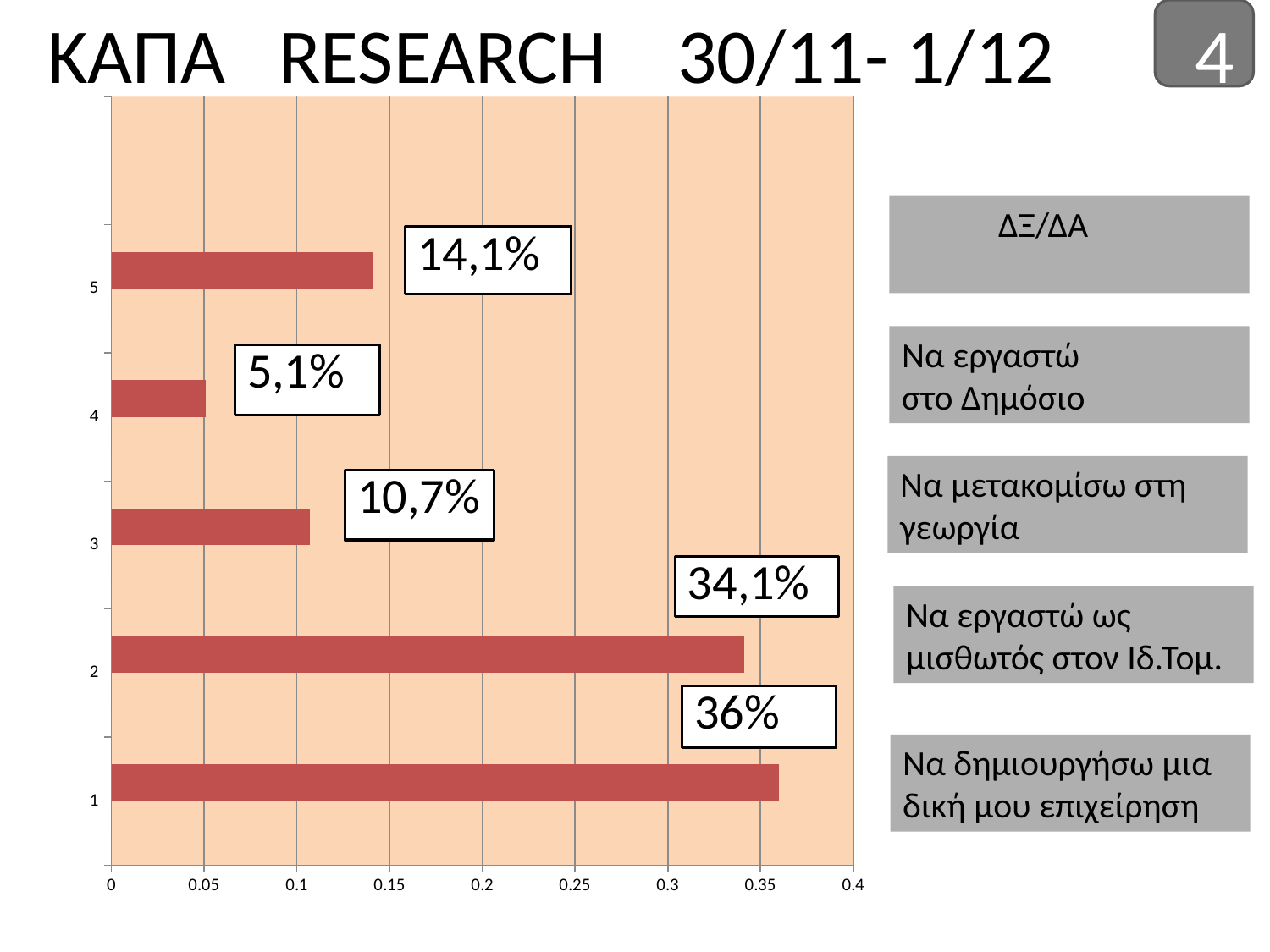
Which category has the highest value? 1 (Να δημιουργήσω μια δική μου επιχείρηση) What is the value for category 1 (Να δημιουργήσω μια δική μου επιχείρηση)? 36% Which is larger, the value for category 3 (Να μετακομίσω στη γεωργία) or category 5 (ΔΞ/ΔΑ)? Category 5 (ΔΞ/ΔΑ) Which category has the lowest value? 4 (Να εργαστώ στο Δημόσιο) What is the value for category 2 (Να εργαστώ ως μισθωτός στον Ιδ.Τομ.)? 34,1% What kind of chart is shown on the slide? Bar chart What is the value for category 3 (Να μετακομίσω στη γεωργία)? 10,7% What is the value for category 5 (ΔΞ/ΔΑ)? 14,1% What is the value for category 4 (Να εργαστώ στο Δημόσιο)? 5,1% What is the difference between the values for category 5 (ΔΞ/ΔΑ) and category 4 (Να εργαστώ στο Δημόσιο)? 9% Is the value for category 2 greater or less than 0.3? greater How many categories are shown in the chart? 5